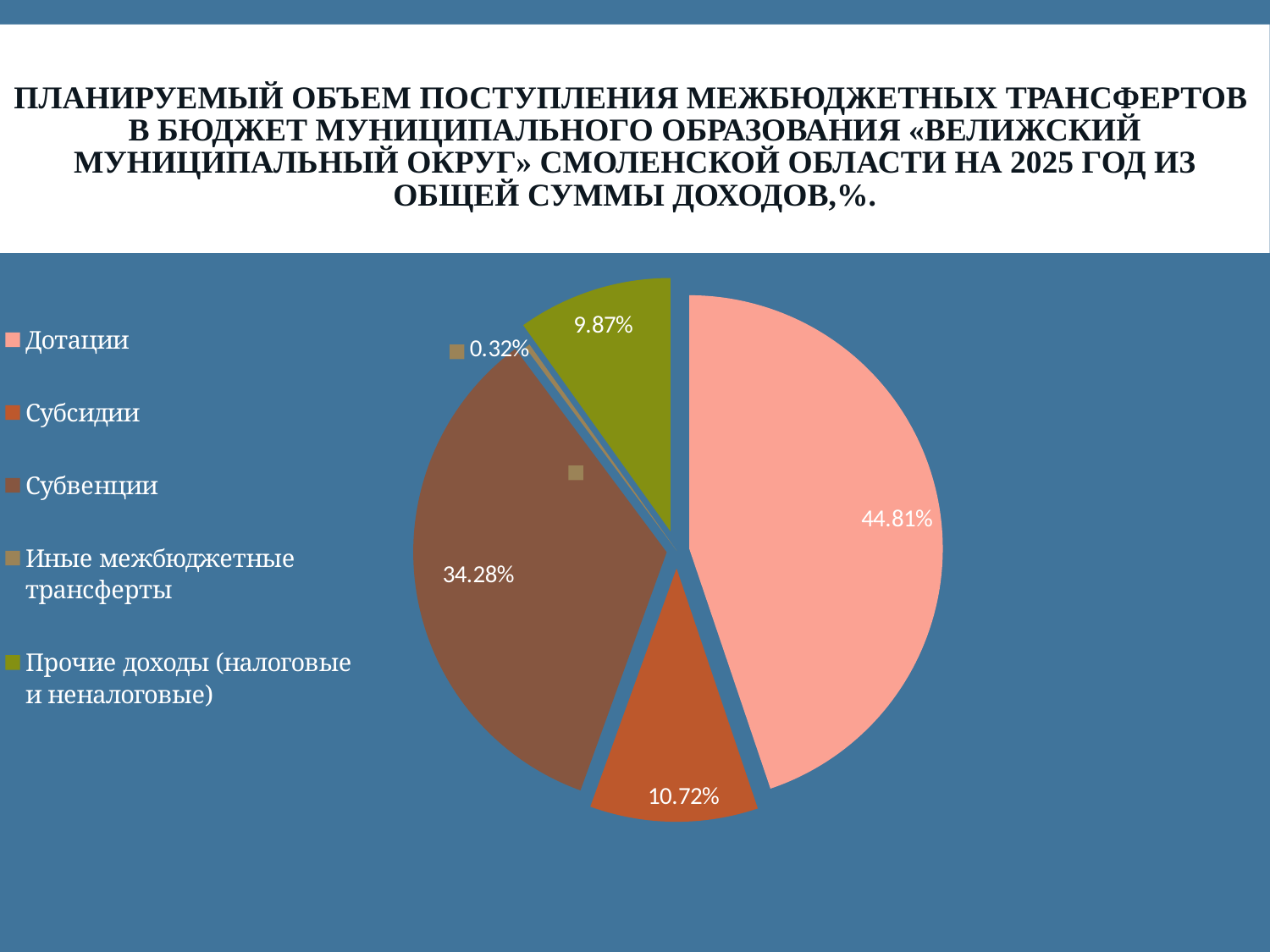
What share is shown for Прочие доходы (налоговые и неналоговые)? 9.87% Which category has the smallest slice of the pie? Иные межбюджетные трансферты What share of the pie does Дотации account for? 44.81% What is the value shown for Субвенции? 34.28% What is the difference in percentage points between Дотации and Субвенции? 10.53 Which category has the largest slice of the pie? Дотации What is the value for Иные межбюджетные трансферты? 0.32% What is the difference in percentage points between Субсидии and Прочие доходы (налоговые и неналоговые)? 0.85 Which is larger, Субсидии or Прочие доходы (налоговые и неналоговые)? Субсидии What type of chart is shown on the slide? Pie chart What percentage is shown for Субсидии? 10.72% How many categories does the pie chart show? 5